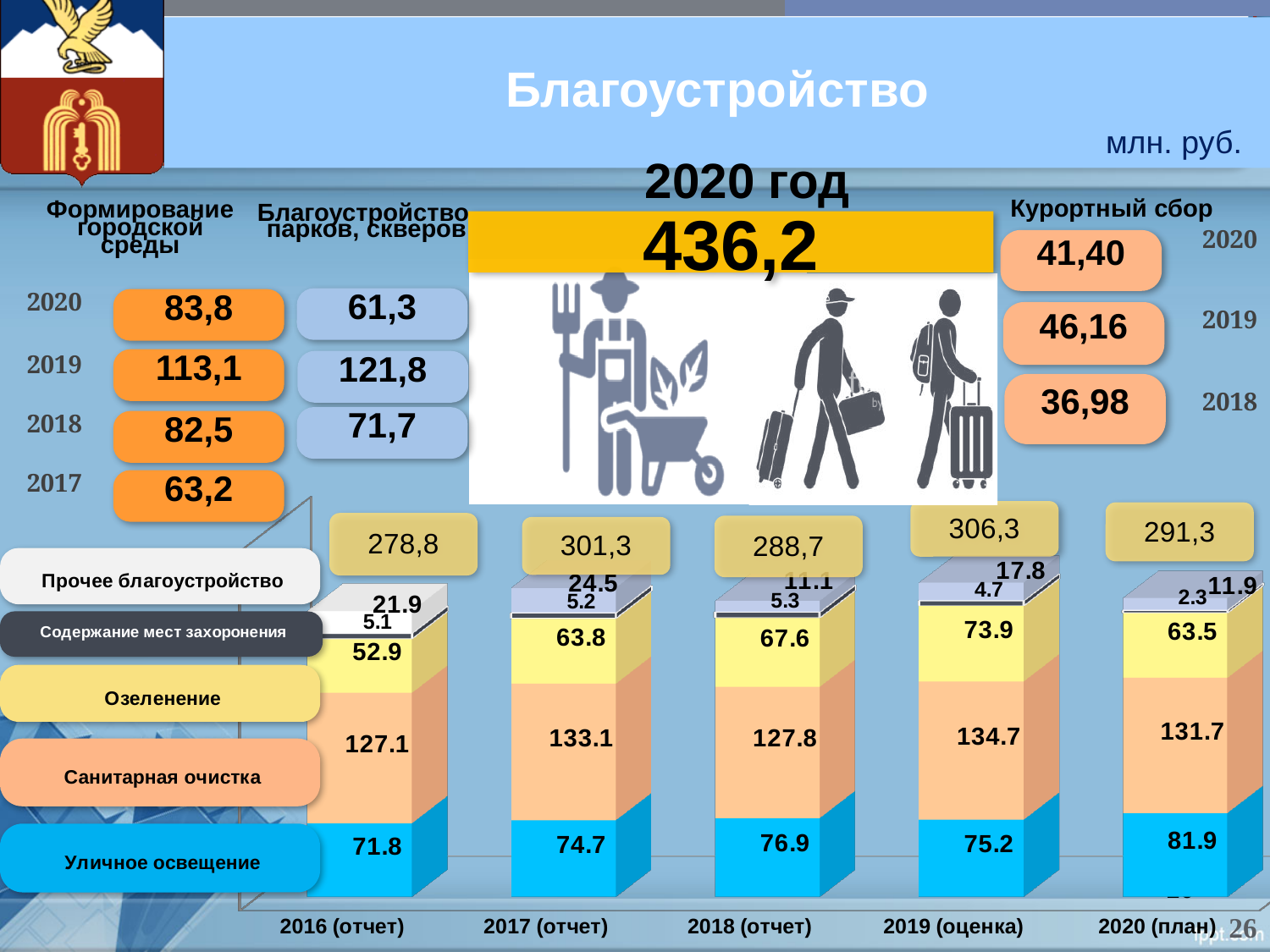
In the stacked bar chart at the bottom, what is the value of Озеленение for 2019 (оценка)? 73.9 In the stacked bar chart at the bottom, what is the difference between Озеленение in 2018 (отчет) and 2017 (отчет)? 3.8 How many series does the legend of the stacked bar chart at the bottom list? 5 In the stacked bar chart at the bottom, is Санитарная очистка larger in 2019 (оценка) or 2018 (отчет)? 2019 (оценка) In the stacked bar chart at the bottom, in which year is Уличное освещение highest? 2020 (план) In the stacked bar chart at the bottom, what is the total shown above the bar for 2019 (оценка)? 306,3 How many years are shown on the x axis of the stacked bar chart at the bottom? 5 In the stacked bar chart at the bottom, which year has the lowest total? 2016 (отчет) In the stacked bar chart at the bottom, what is the value of Санитарная очистка for 2017 (отчет)? 133.1 In the stacked bar chart at the bottom, what is the value of Содержание мест захоронения for 2020 (план)? 2.3 In the stacked bar chart at the bottom, what is the value of Уличное освещение for 2020 (план)? 81.9 In the stacked bar chart at the bottom, in which year is Озеленение lowest? 2016 (отчет)